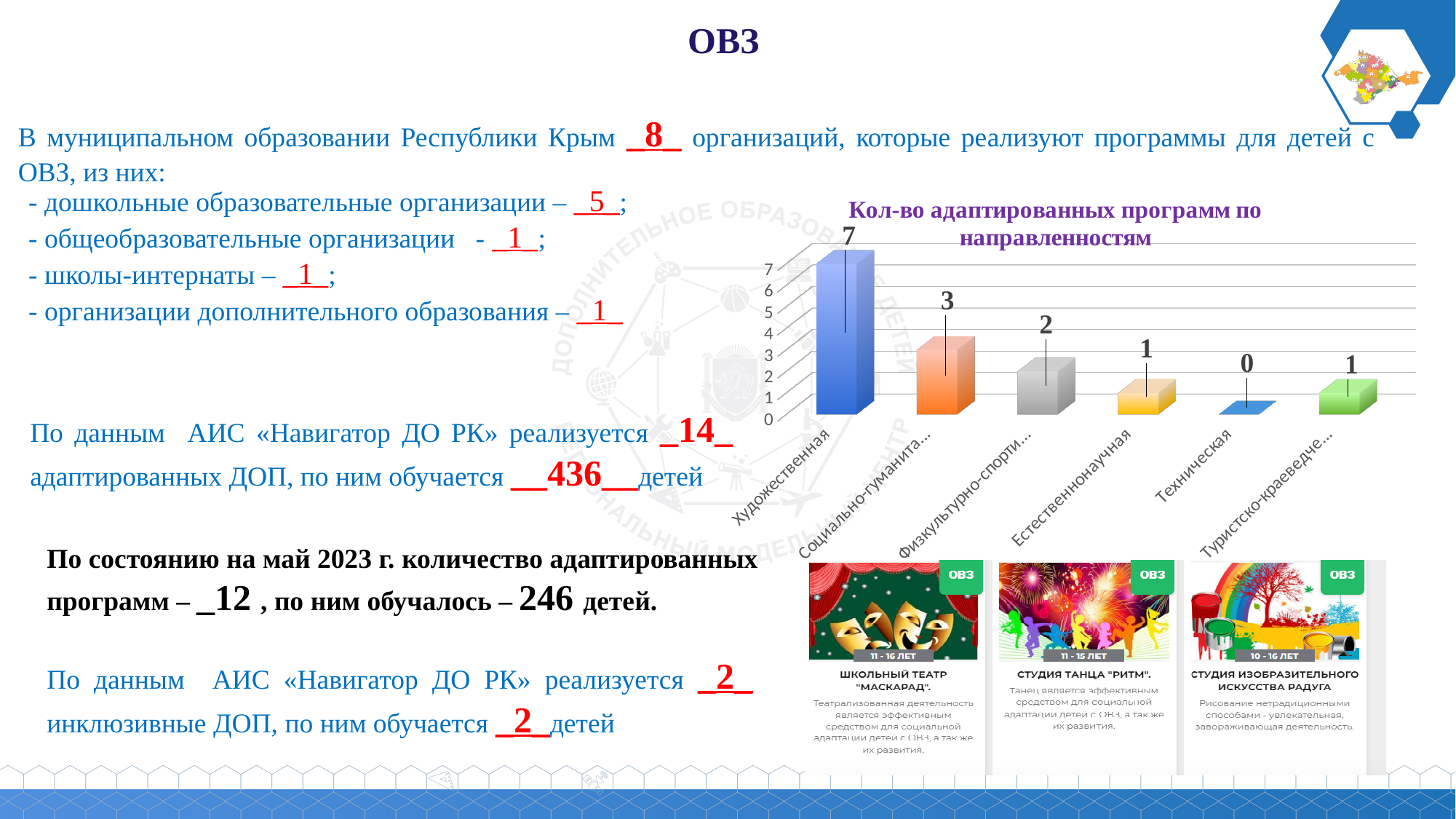
How many categories are shown in the chart? 6 Which category has the lowest value in the chart? Техническая What is the value for Художественная in the chart? 7 What is the value for Техническая in the chart? 0 What is the value for Естественнонаучная in the chart? 1 Is the value for Художественная greater or less than 5? greater What is the title of the chart? Кол-во адаптированных программ по направленностям What is the sum of all the values shown in the chart? 14 Which is larger, the value for Художественная or the value for Техническая? Художественная Which category has the highest value in the chart? Художественная What is the difference between the values for Художественная and Естественнонаучная? 6 What kind of chart is shown on the slide? bar chart